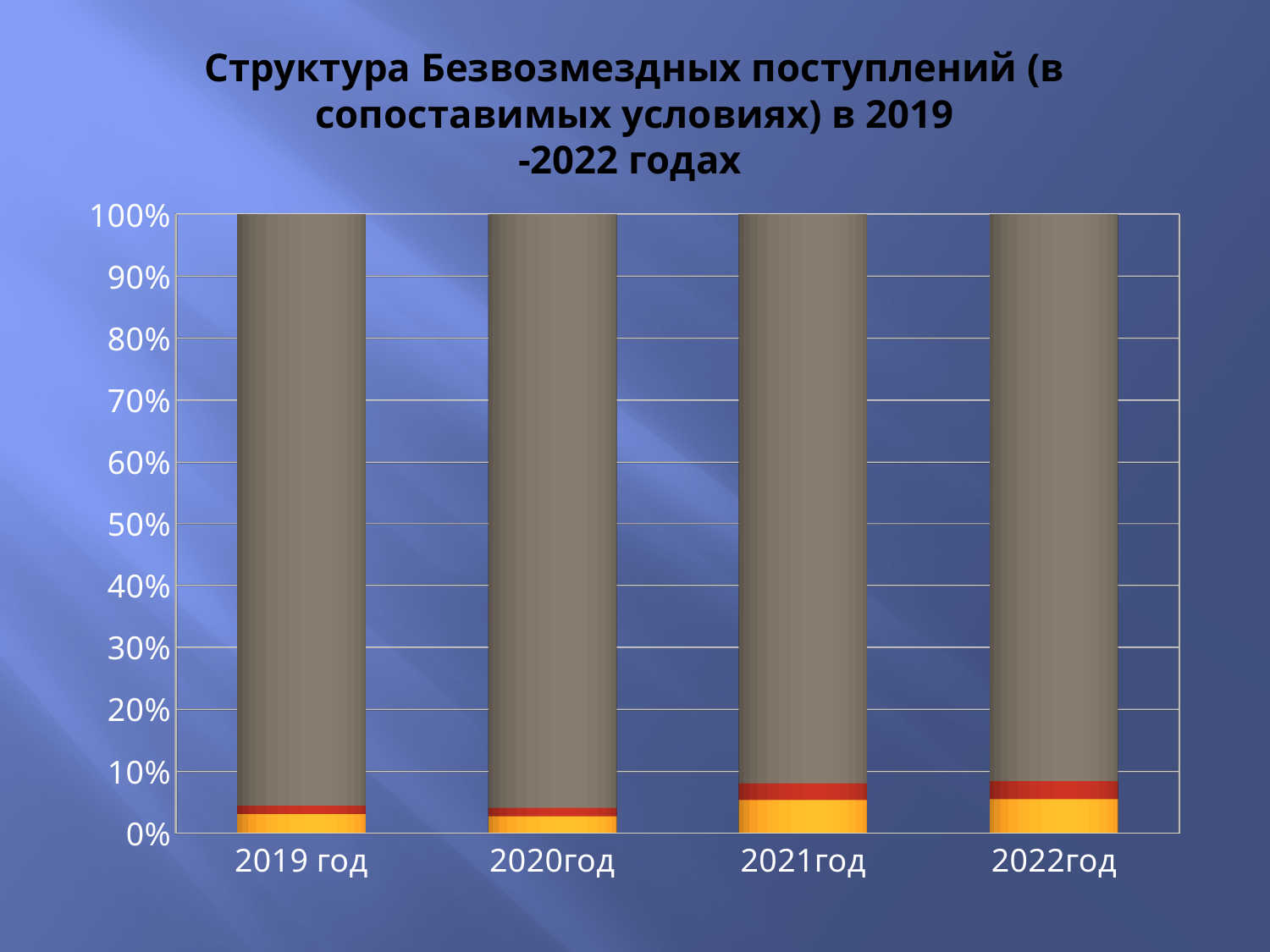
How many years (categories) are shown on the x axis? 4 Which category label is shown first on the x axis? 2019 год What is the total height of the stacked bar for 2019 год? 100% Which is larger: the yellow (bottom) segment for 2021год or for 2019 год? 2021год What is the title of the chart? Структура Безвозмездных поступлений (в сопоставимых условиях) в 2019-2022 годах How many coloured segments make up each stacked bar? 3 Is the yellow (bottom) segment for 2021год greater or less than 10%? less Is the grey (top) segment for 2022год greater or less than 80%? greater Is the grey (top) segment for 2019 год greater or less than 90%? greater What is the highest value shown on the vertical axis? 100% What kind of chart is shown on the slide? stacked bar chart Which is larger: the grey (top) segment for 2020год or for 2022год? 2020год